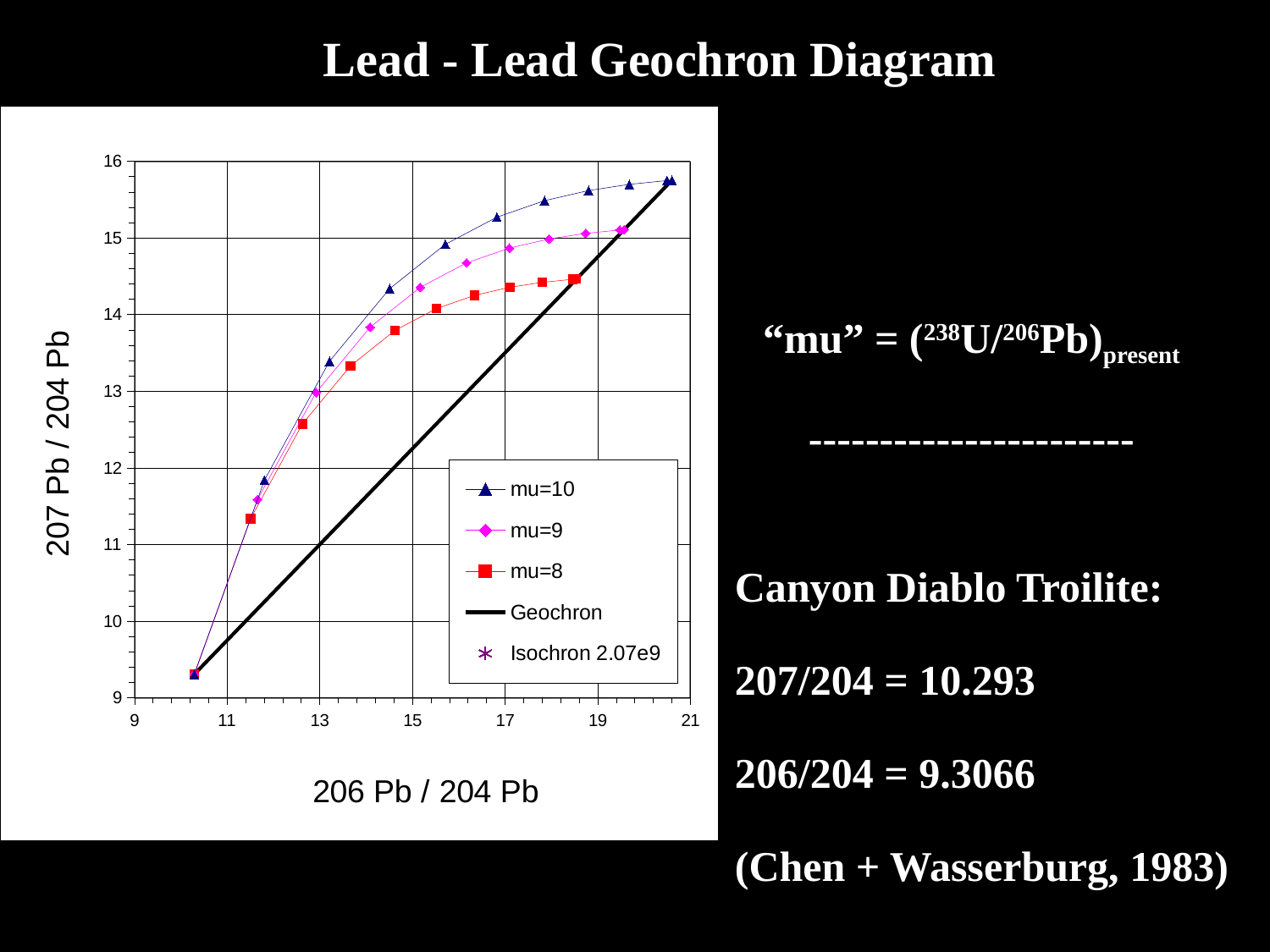
At the right end of the curves, which series reaches a higher 207 Pb / 204 Pb value, mu=10 or mu=8? mu=10 Do the values of the mu=10 series rise or fall as 206 Pb / 204 Pb increases? rise Which mu series stays lowest in 207 Pb / 204 Pb across the chart? mu=8 Is the 206 Pb / 204 Pb value at the starting point of the curves greater or less than 11? less Is the highest 207 Pb / 204 Pb value of the mu=9 series greater or less than 14? greater Is the highest 207 Pb / 204 Pb value of the mu=8 series greater or less than 15? less What is the title of the chart? Lead - Lead Geochron Diagram Which mu series reaches the highest 207 Pb / 204 Pb value? mu=10 What kind of chart is shown on the slide? line chart How many series does the chart legend list? 5 What label is on the vertical axis of the chart? 207 Pb / 204 Pb